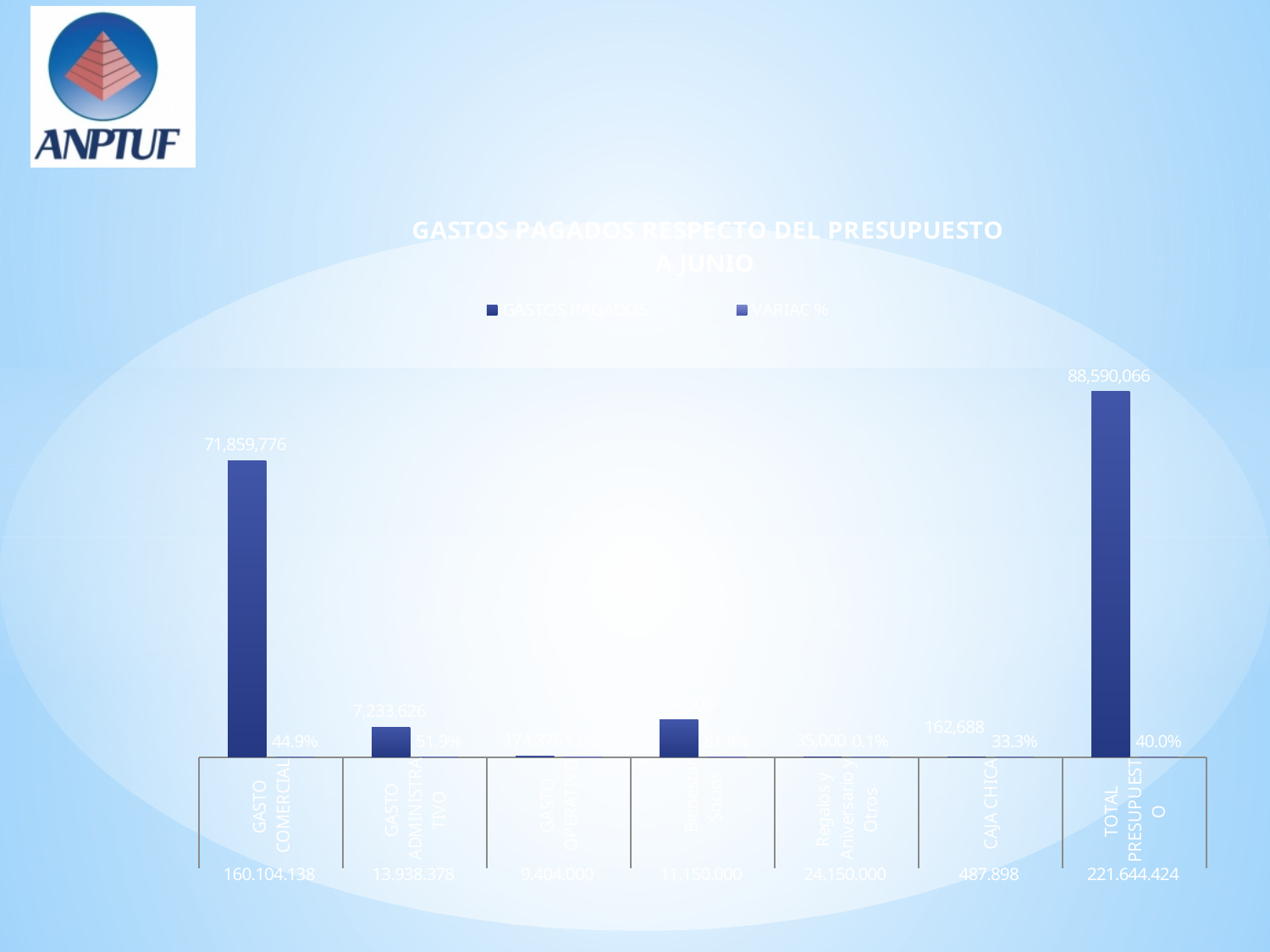
What is the GASTOS PAGADOS value for CAJA CHICA? 162,688 What is the GASTOS PAGADOS value for GASTO COMERCIAL? 71,859,776 What is the difference between the GASTOS PAGADOS values for TOTAL PRESUPUESTO and GASTO COMERCIAL? 16,730,290 What is the VARIAC % value for TOTAL PRESUPUESTO? 40.0% Which category has the highest GASTOS PAGADOS value? TOTAL PRESUPUESTO Which has a larger GASTOS PAGADOS value, GASTO ADMINISTRATIVO or CAJA CHICA? GASTO ADMINISTRATIVO How many categories are shown on the x axis of the chart? 7 What type of chart is shown on the slide? Bar chart How many series does the legend list? 2 What is the GASTOS PAGADOS value for TOTAL PRESUPUESTO? 88,590,066 What is the VARIAC % value for GASTO COMERCIAL? 44.9% What is the GASTOS PAGADOS value for GASTO ADMINISTRATIVO? 7,233,626